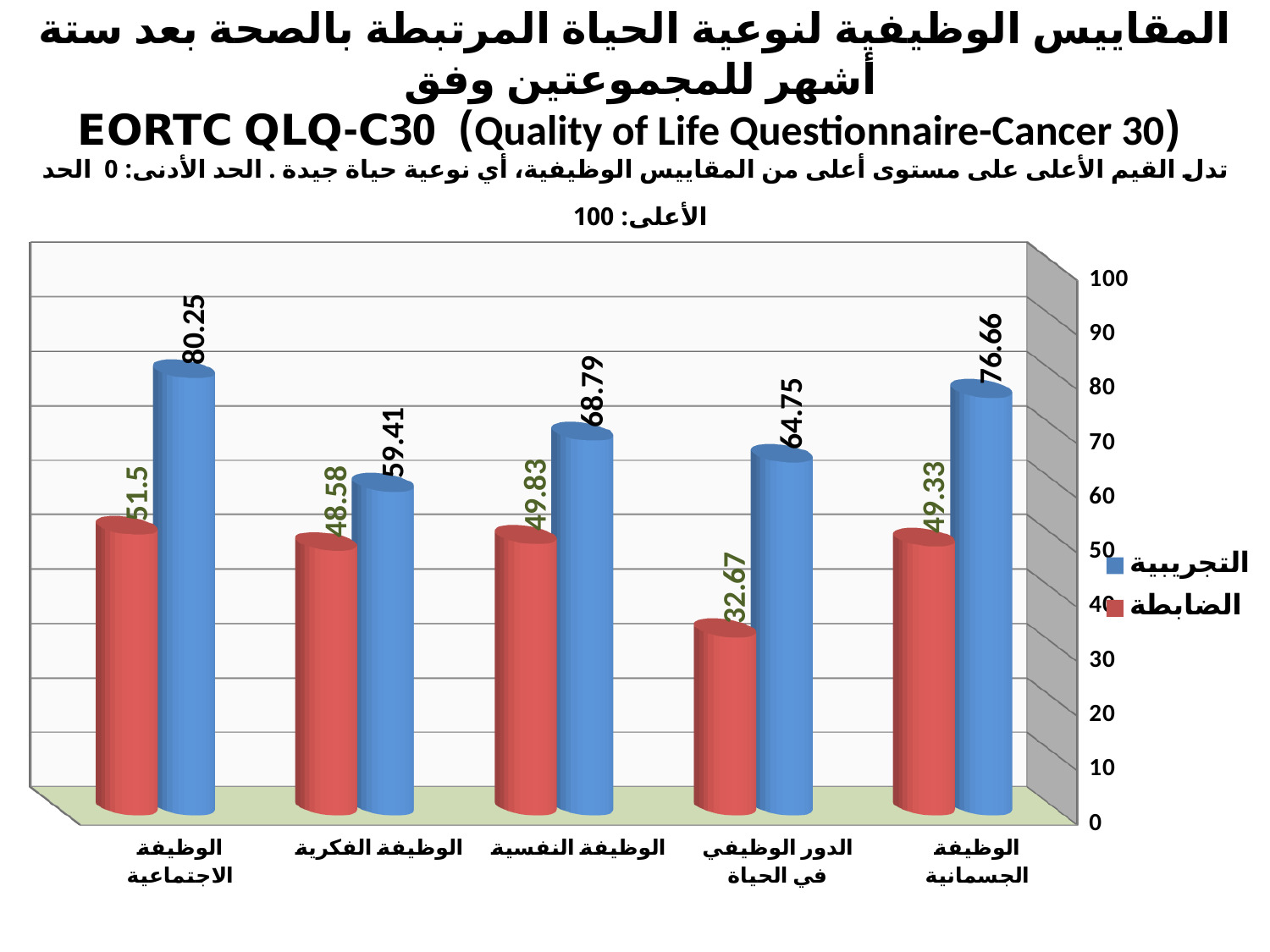
What is the value for التجريبية in الوظيفة الجسمانية? 76.66 Which category has the lowest value for الضابطة? الدور الوظيفي في الحياة How many categories are shown on the x axis? 5 What is the difference between التجريبية and الضابطة in الوظيفة النفسية? 18.96 What kind of chart is shown on the slide? bar chart Which category has the highest value for التجريبية? الوظيفة الاجتماعية What is the value for الضابطة in الوظيفة الفكرية? 48.58 Which colour represents the الضابطة series? red What is the value for التجريبية in الوظيفة الاجتماعية? 80.25 How many series does the legend list? 2 Which is larger in الوظيفة الفكرية: التجريبية or الضابطة? التجريبية What is the value for الضابطة in الدور الوظيفي في الحياة? 32.67